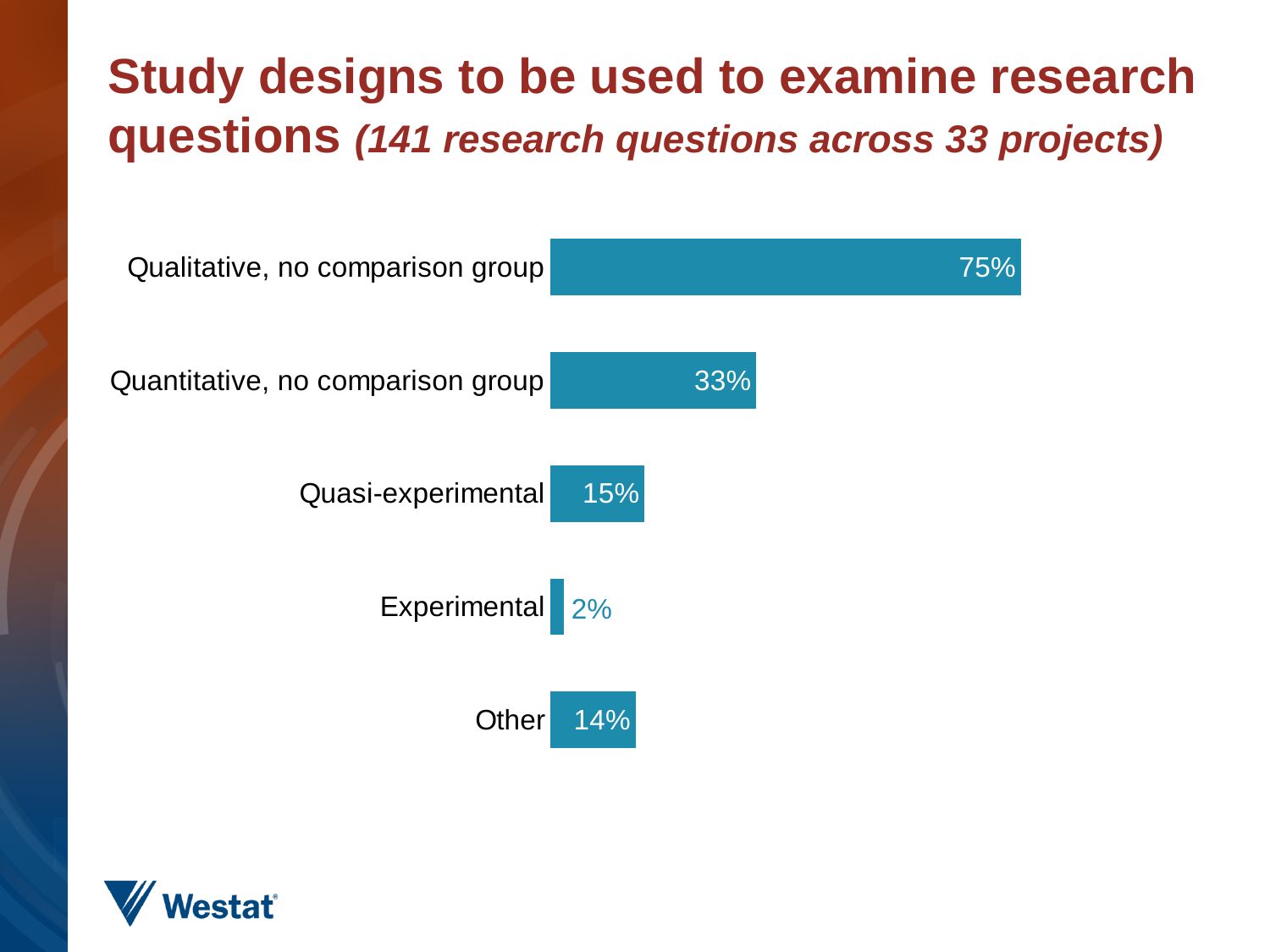
What is the value for Experimental? 2% How many study design categories are shown in the chart? 5 Which is larger, the value for Quasi-experimental or the value for Other? Quasi-experimental What is the value shown for Quantitative, no comparison group? 33% What is the difference in percentage points between Qualitative, no comparison group and Quantitative, no comparison group? 42 What percentage of research questions use a qualitative, no comparison group design? 75% Which study design has the lowest percentage? Experimental According to the slide title, how many research questions across how many projects are covered? 141 research questions across 33 projects Which study design has the highest percentage? Qualitative, no comparison group What type of chart is shown on the slide? Bar chart What percentage is shown for Other? 14% What percentage is shown for Quasi-experimental? 15%